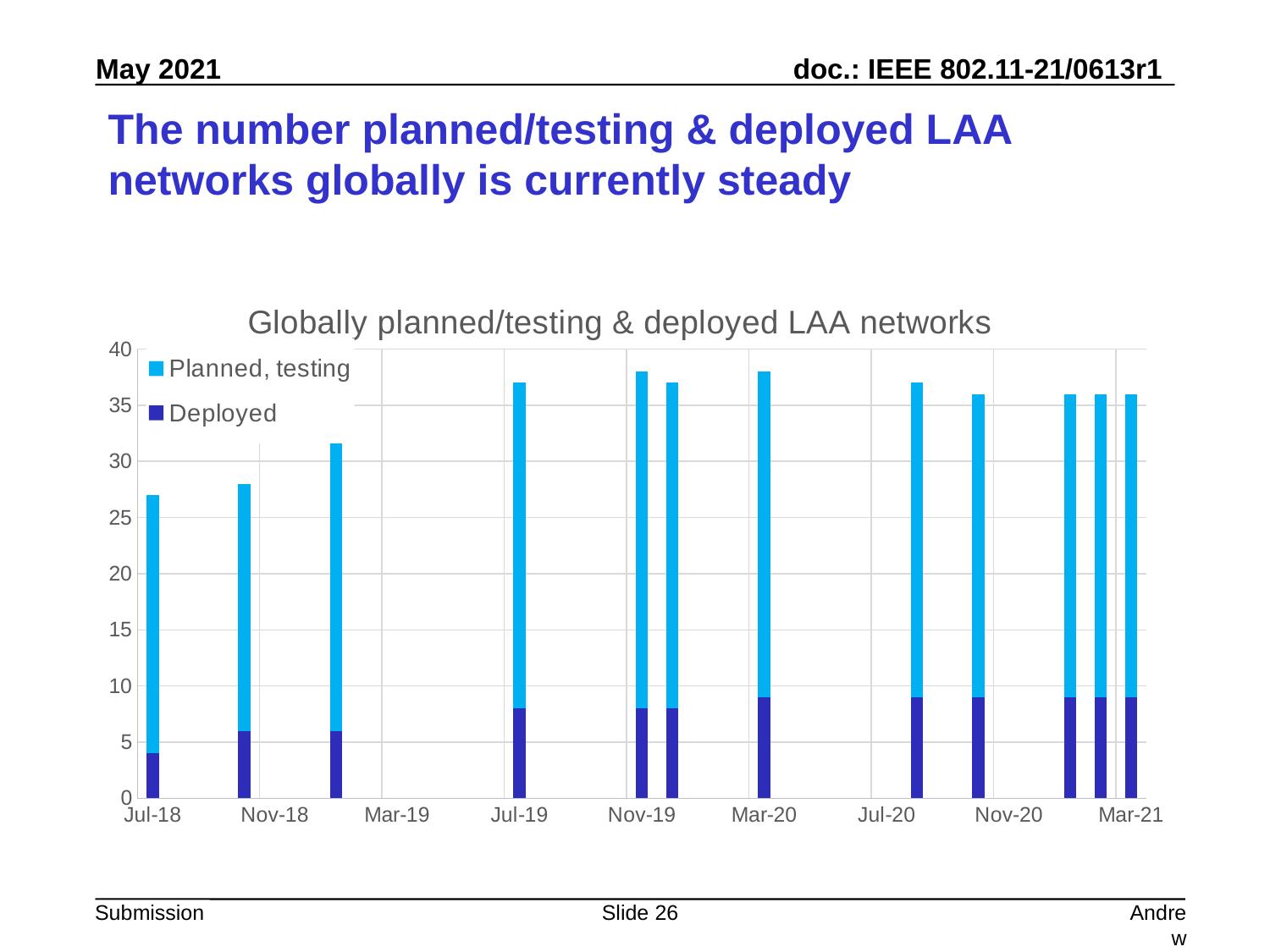
Is the total height of the bar at Mar-21 greater or less than 30? greater Is the total height of the bar at Jul-19 greater or less than 35? greater What kind of chart is shown on the slide? Stacked bar chart Is the total height of the bar at Jul-18 greater or less than 30? less What is the title of the chart? Globally planned/testing & deployed LAA networks How many bars are plotted in the chart? 12 Which bar has the larger total, Jul-18 or Jul-19? Jul-19 How many series does the chart legend list? 2 Do the total bar heights rise or fall from Jul-18 to Jul-19? rise Which series is shown in dark blue in the chart? Deployed